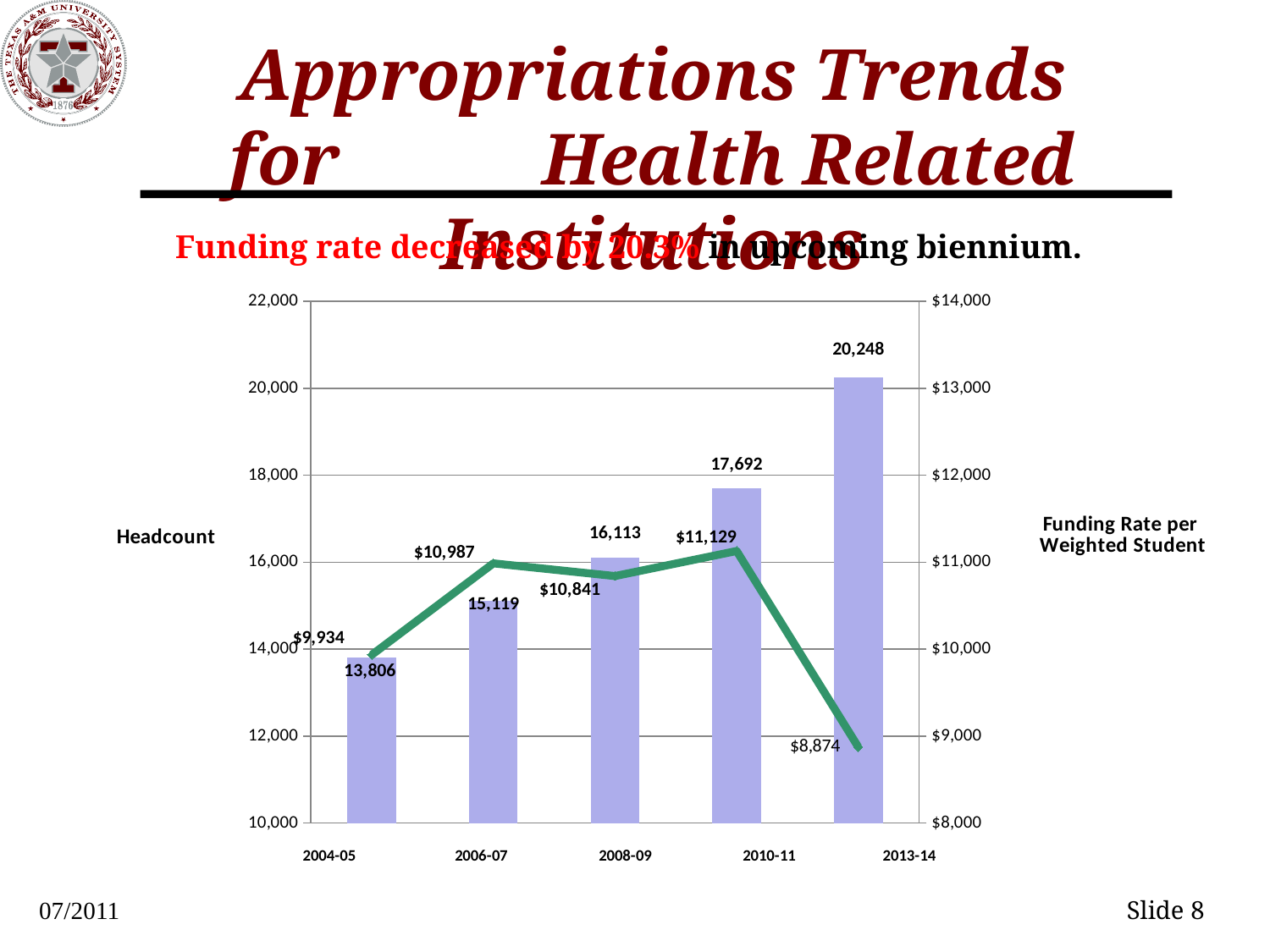
Which period has the highest headcount? 2013-14 What is the headcount for 2013-14? 20,248 What is the label of the right-hand vertical axis? Funding Rate per Weighted Student What is the headcount for 2004-05? 13,806 What is the funding rate per weighted student for 2013-14? $8,874 Which period has the lowest funding rate per weighted student? 2013-14 How many periods are shown on the x axis? 5 Does the headcount rise or fall from 2004-05 to 2013-14? Rise What is the funding rate per weighted student for 2006-07? $10,987 Which period has the highest funding rate per weighted student? 2010-11 What is the difference in headcount between 2013-14 and 2010-11? 2,556 Which is larger, the funding rate per weighted student in 2008-09 or in 2010-11? 2010-11